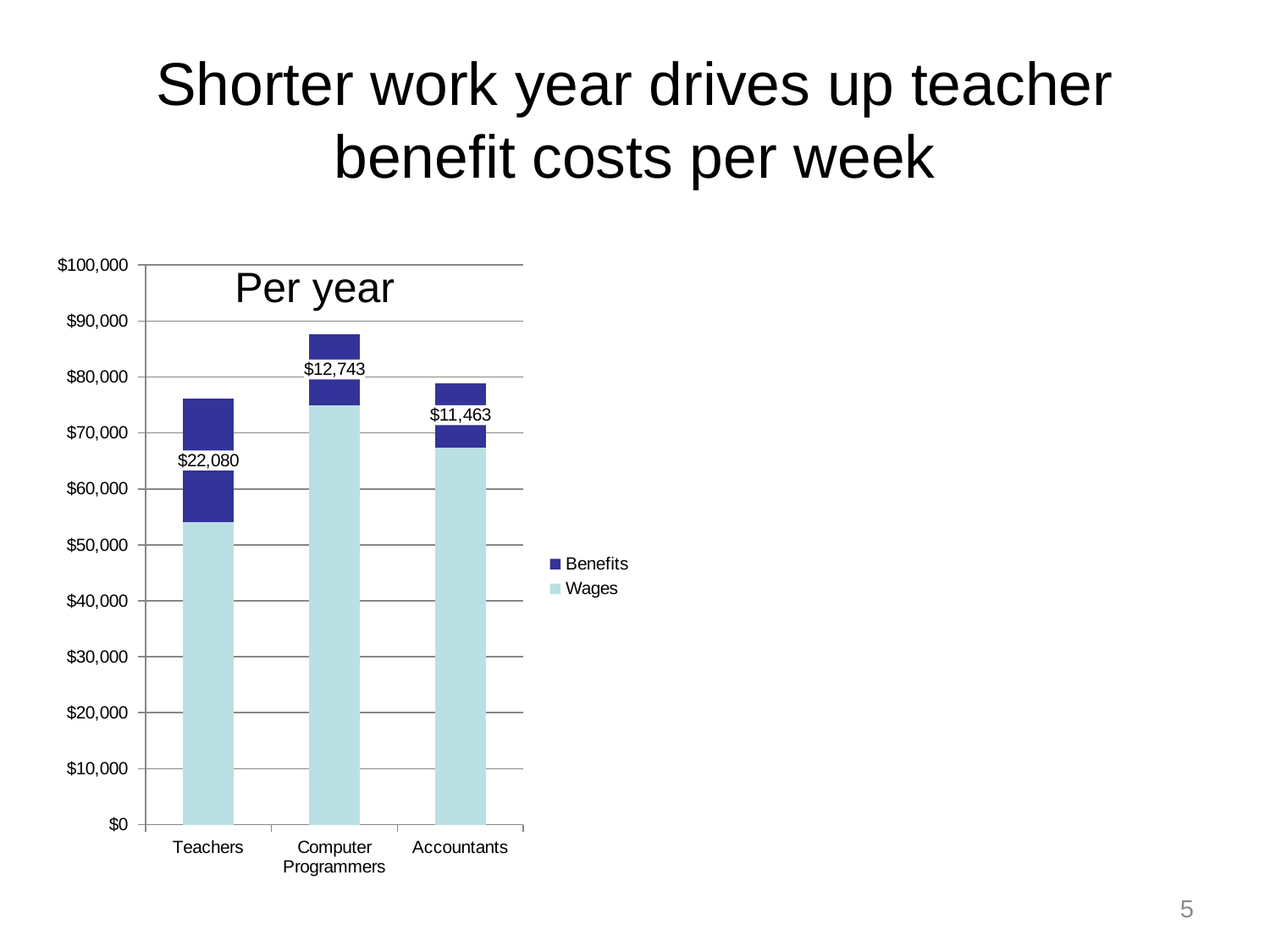
What is the difference between the Benefits value for Teachers and the Benefits value for Computer Programmers? $9,337 Is the total bar height for Computer Programmers greater or less than $80,000? greater What is the Benefits value for Computer Programmers? $12,743 Which category has the lowest Benefits value? Accountants Which category has the highest Benefits value? Teachers How many series does the legend list? 2 What is the Benefits value for Accountants? $11,463 What kind of chart is shown on the slide? Stacked bar chart Which is larger, the Benefits value for Computer Programmers or the Benefits value for Accountants? Computer Programmers How many categories are shown on the x axis? 3 Is the Wages value for Teachers greater or less than $50,000? greater What is the Benefits value for Teachers? $22,080